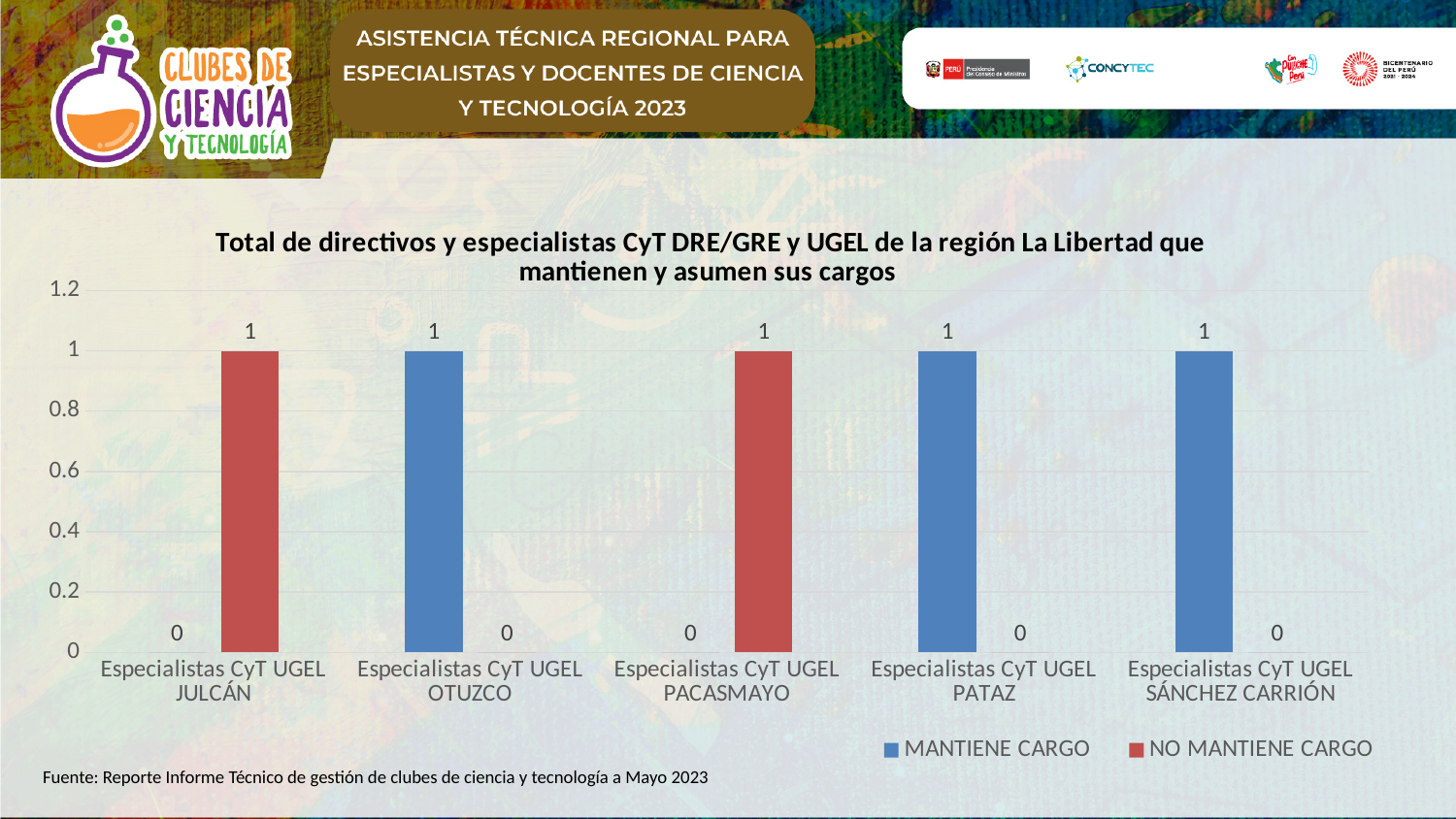
What is the source cited below the chart? Reporte Informe Técnico de gestión de clubes de ciencia y tecnología a Mayo 2023 How many series does the legend list? 2 What is the value of NO MANTIENE CARGO for Especialistas CyT UGEL SÁNCHEZ CARRIÓN? 0 Is the value of NO MANTIENE CARGO for Especialistas CyT UGEL PACASMAYO greater or less than 0.8? greater What is the value of NO MANTIENE CARGO for Especialistas CyT UGEL JULCÁN? 1 How many categories are shown on the x axis? 5 Which series is shown in red in the legend? NO MANTIENE CARGO What kind of chart is shown on the slide? Bar chart Which is larger for Especialistas CyT UGEL PATAZ: MANTIENE CARGO or NO MANTIENE CARGO? MANTIENE CARGO What is the value of MANTIENE CARGO for Especialistas CyT UGEL OTUZCO? 1 What is the value of MANTIENE CARGO for Especialistas CyT UGEL PACASMAYO? 0 What is the difference between the MANTIENE CARGO value for Especialistas CyT UGEL PATAZ and the MANTIENE CARGO value for Especialistas CyT UGEL JULCÁN? 1